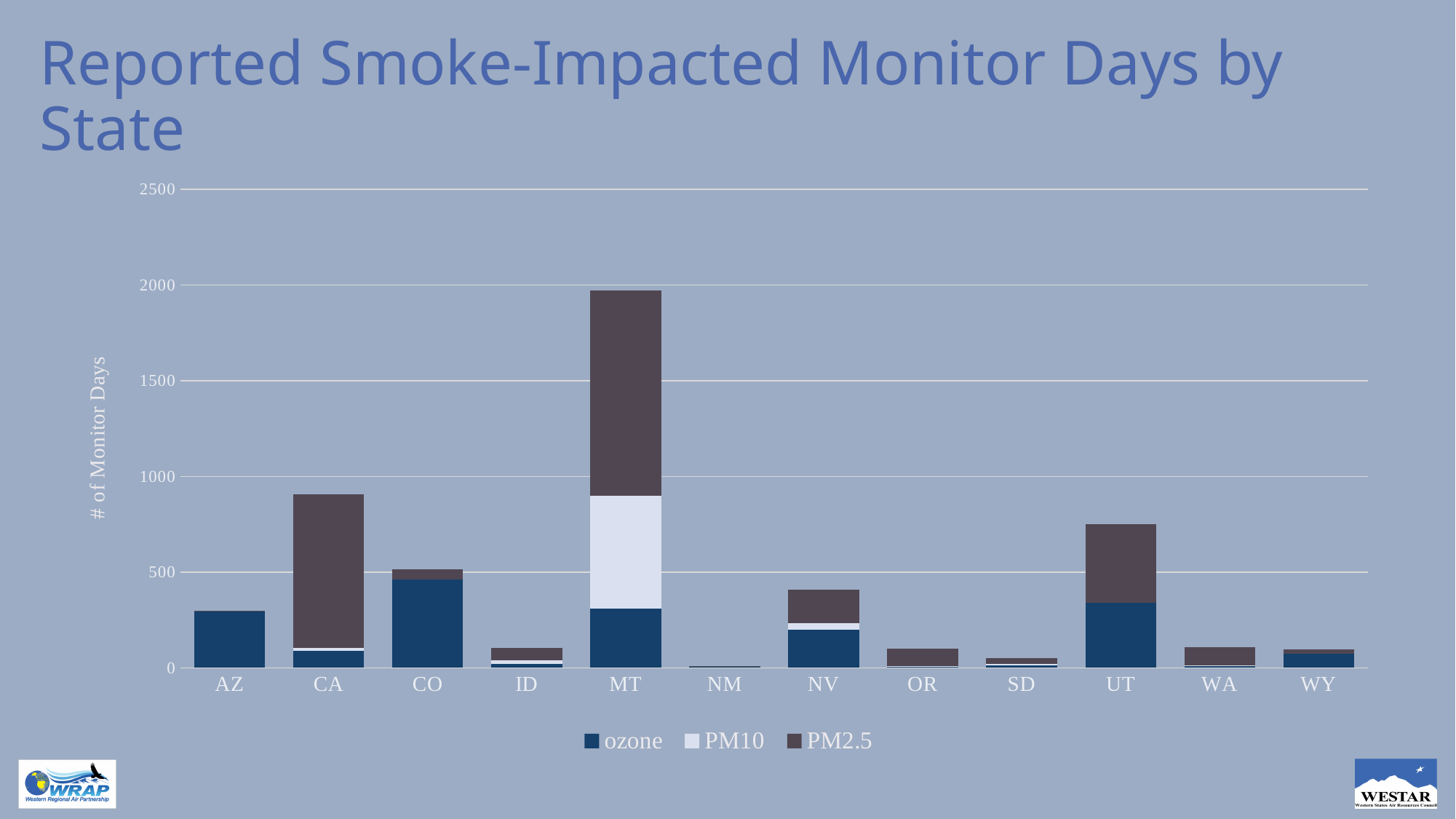
Which state has the highest total number of monitor days? MT Is the total value for MT greater or less than 1500? greater Is the total value for CA greater or less than 1000? less Is the total value for UT greater or less than 500? greater What is the label on the y axis? # of Monitor Days How many states are shown along the x axis? 12 Which state has the lowest total number of monitor days? NM Which state has a larger total, AZ or WA? AZ How many series does the legend list? 3 What kind of chart is shown on the slide? Stacked bar chart Which state has a larger total, CA or UT? CA